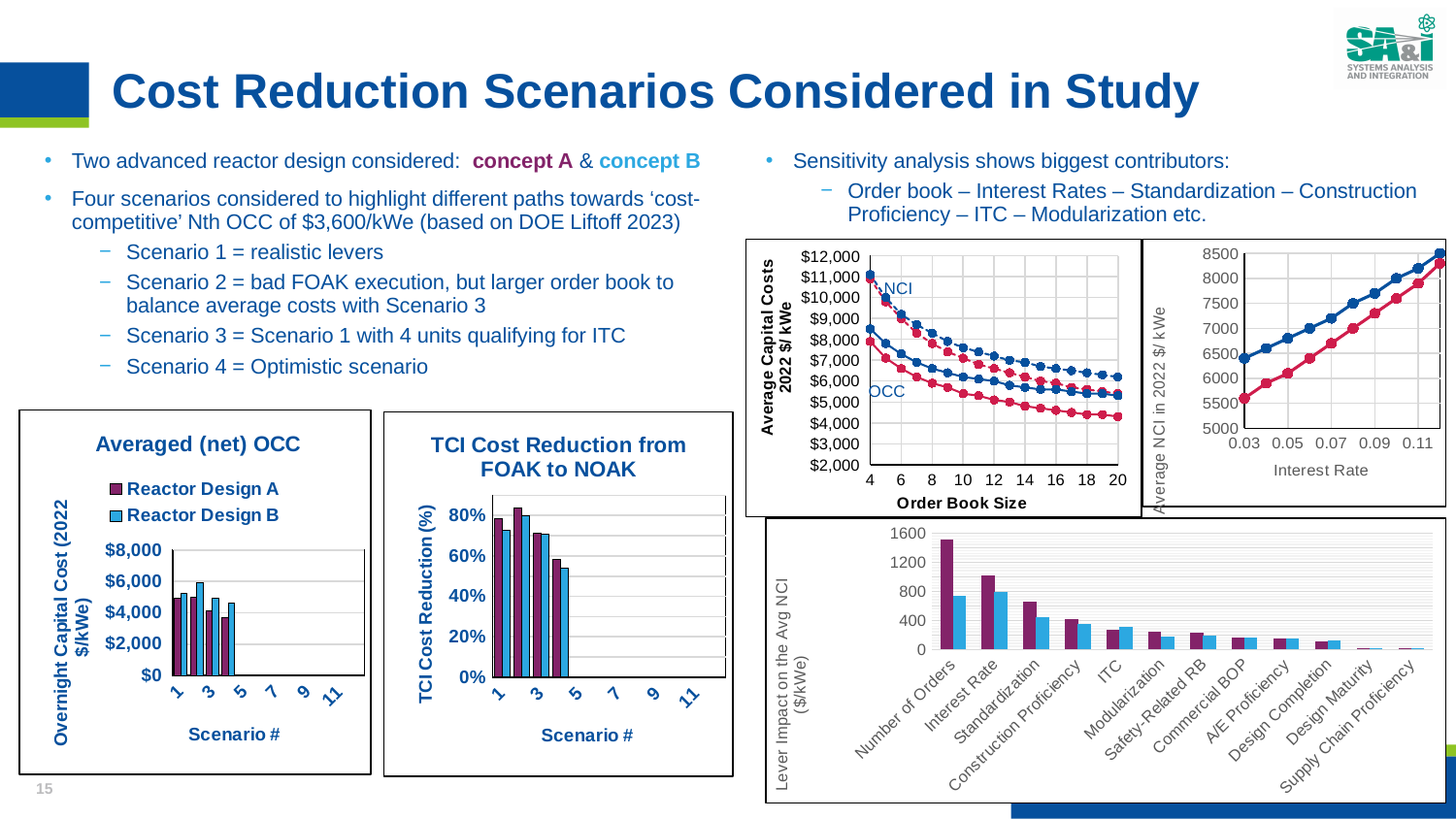
How many lever categories are shown in the "Lever Impact on the Avg NCI" bar chart? 12 In the "Lever Impact on the Avg NCI" bar chart, which lever has the highest impact? Number of Orders What are the two legend entries in the "Averaged (net) OCC" chart? Reactor Design A and Reactor Design B How many series does the legend of the "Averaged (net) OCC" chart list? 2 In the "TCI Cost Reduction from FOAK to NOAK" chart, is the Reactor Design A value for scenario 1 greater or less than 60%? greater In the line chart of Average Capital Costs versus Order Book Size, is the NCI value at an order book size of 4 greater or less than $10,000? greater In the "TCI Cost Reduction from FOAK to NOAK" chart, which scenario has the lowest TCI cost reduction for Reactor Design B? Scenario 4 In the line chart of Average Capital Costs versus Order Book Size, do the costs rise or fall as the order book size increases? fall In the chart of Average NCI versus Interest Rate, does the average NCI rise or fall as the interest rate increases? rise What kind of chart is the "Averaged (net) OCC" chart? bar chart In the chart of Average NCI versus Interest Rate, is the red line's value at an interest rate of 0.03 greater or less than 6000? less